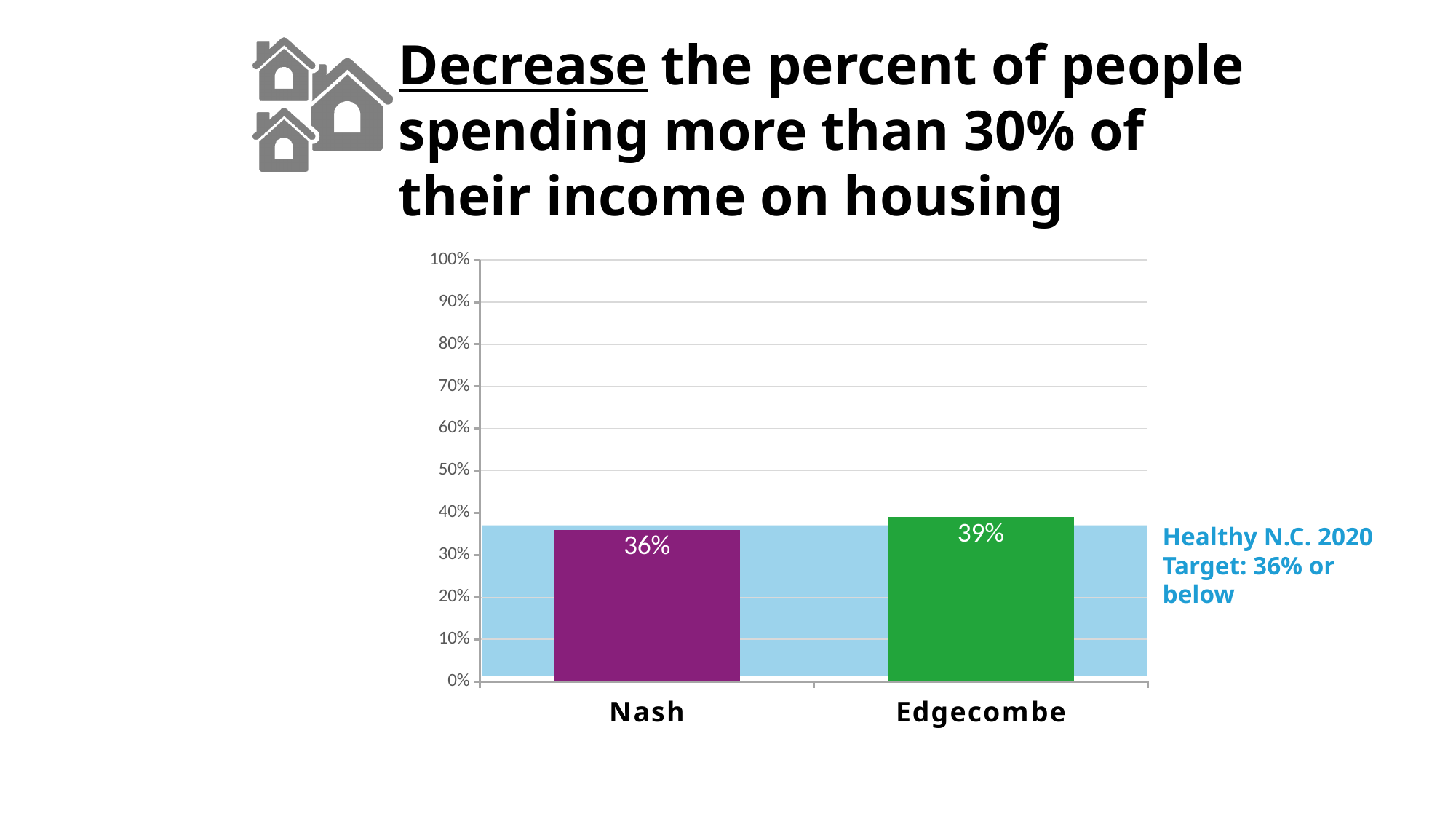
What kind of chart is shown on the slide? bar chart What is the value for Edgecombe? 39% Which county has the higher value? Edgecombe What colour is the bar for Nash? purple Is the value for Edgecombe greater or less than 50%? less What is the difference between the values for Edgecombe and Nash? 3% Which county has the lower value? Nash How many counties are shown on the chart? 2 Is the value for Edgecombe larger or smaller than the value for Nash? larger What is the value for Nash? 36% What is the Healthy N.C. 2020 target shown next to the chart? 36% or below